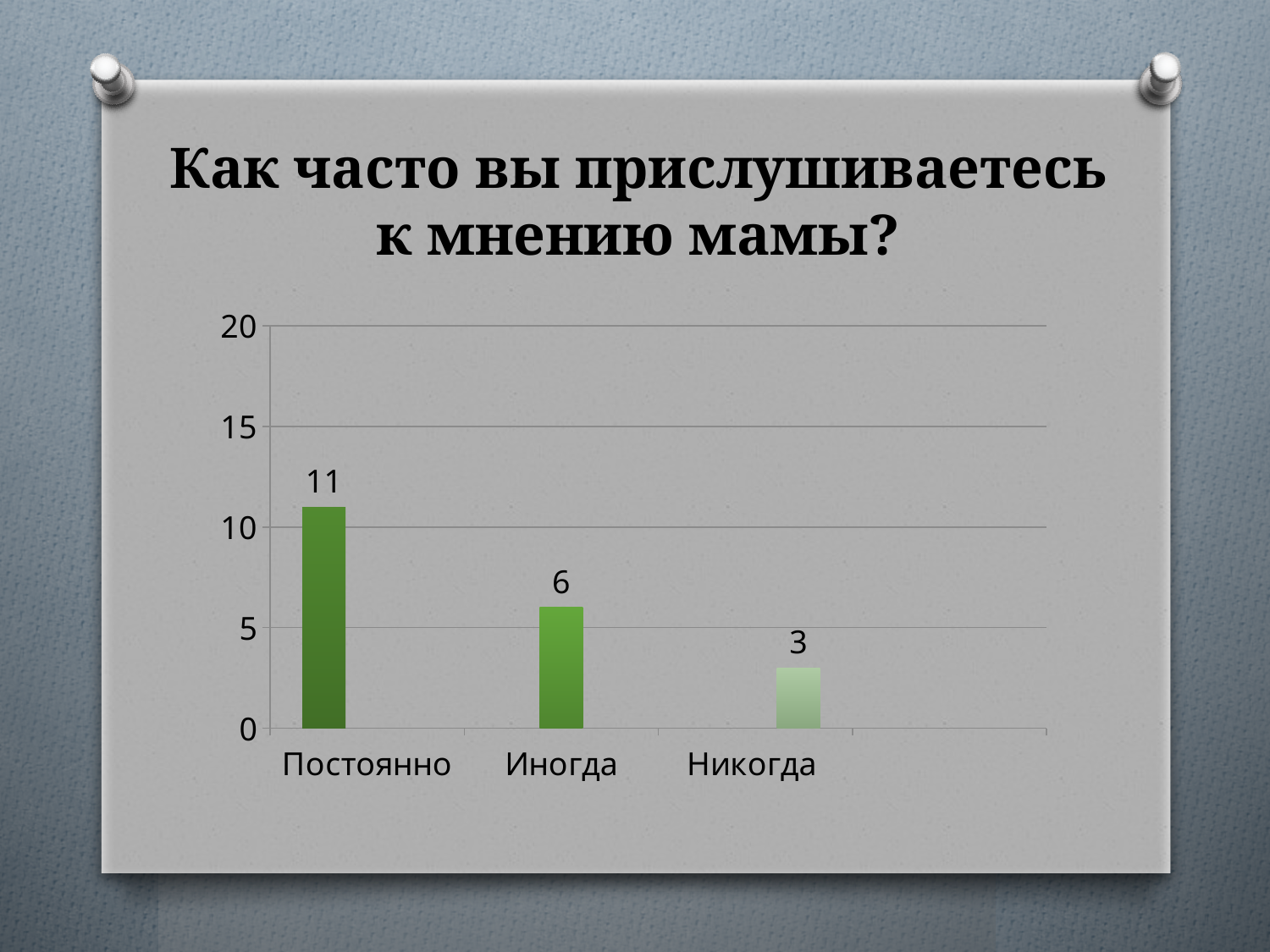
What is the value for Иногда? 6 Which category has the highest value? Постоянно What is the difference between the values for Иногда and Никогда? 3 What is the value for Никогда? 3 Do the values rise or fall from left to right along the x axis? fall What is the difference between the values for Постоянно and Иногда? 5 Which category has the lowest value? Никогда What is the value for Постоянно? 11 Is the value for Постоянно greater or less than 10? greater How many categories are shown on the x axis? 3 What kind of chart is shown on the slide? bar chart Which is larger, the value for Иногда or the value for Никогда? Иногда